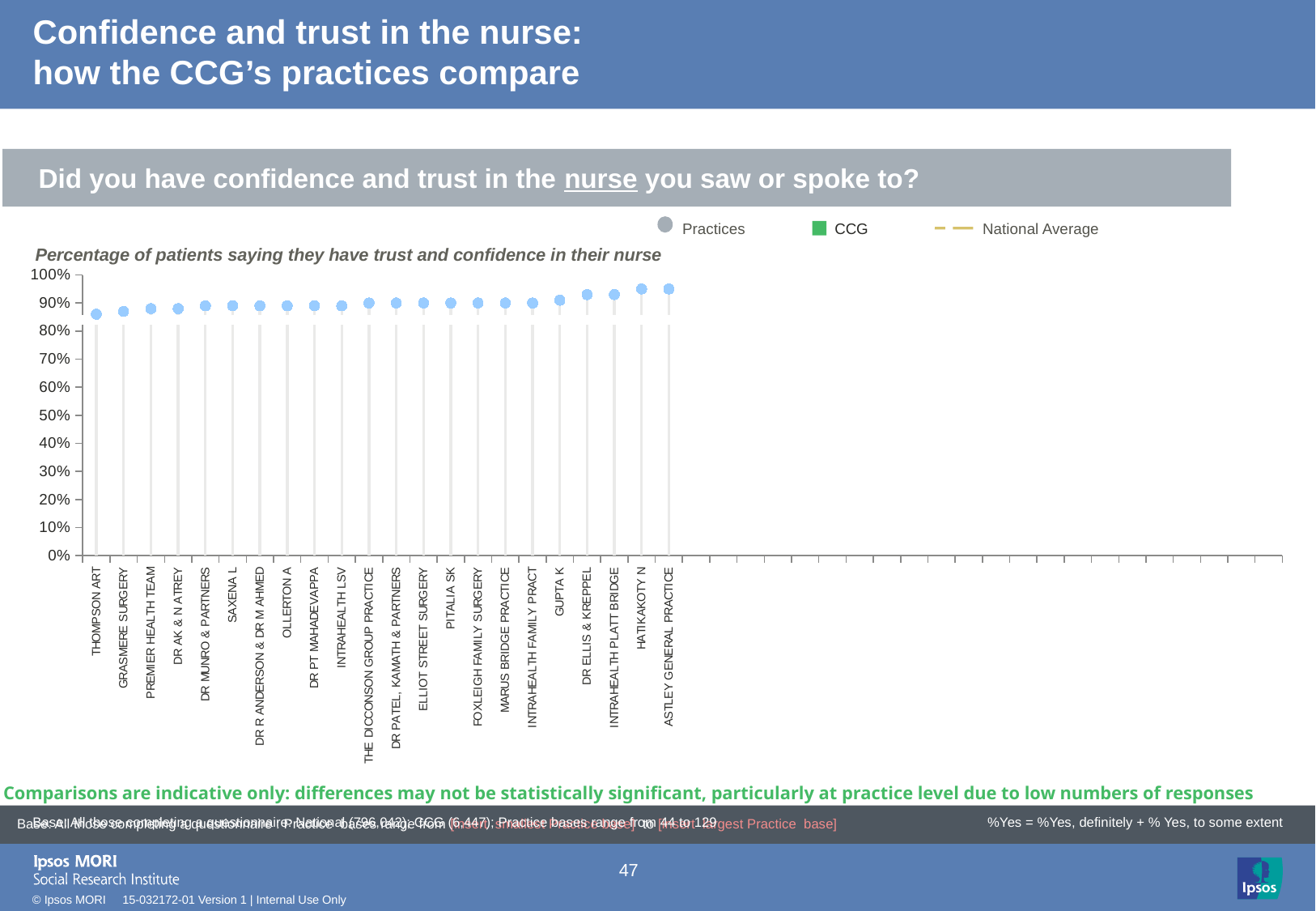
What is the subtitle describing what the chart measures? Percentage of patients saying they have trust and confidence in their nurse Is the value for ASTLEY GENERAL PRACTICE greater or less than 90%? greater Which has the larger value, GRASMERE SURGERY or HATIKAKOTY N? HATIKAKOTY N Which practice has the lowest percentage of patients saying they have trust and confidence in their nurse? THOMPSON ART How many practices are plotted on the chart? 22 Is the value for GRASMERE SURGERY greater or less than 90%? less Do the values rise or fall moving from left to right across the practices? rise Which has the larger value, THOMPSON ART or ASTLEY GENERAL PRACTICE? ASTLEY GENERAL PRACTICE What are the three entries in the chart legend? Practices, CCG, National Average How many series does the legend list? 3 What kind of chart is used to show the percentage of patients saying they have trust and confidence in their nurse? Dot (lollipop) chart Is the value for THOMPSON ART greater or less than 80%? greater